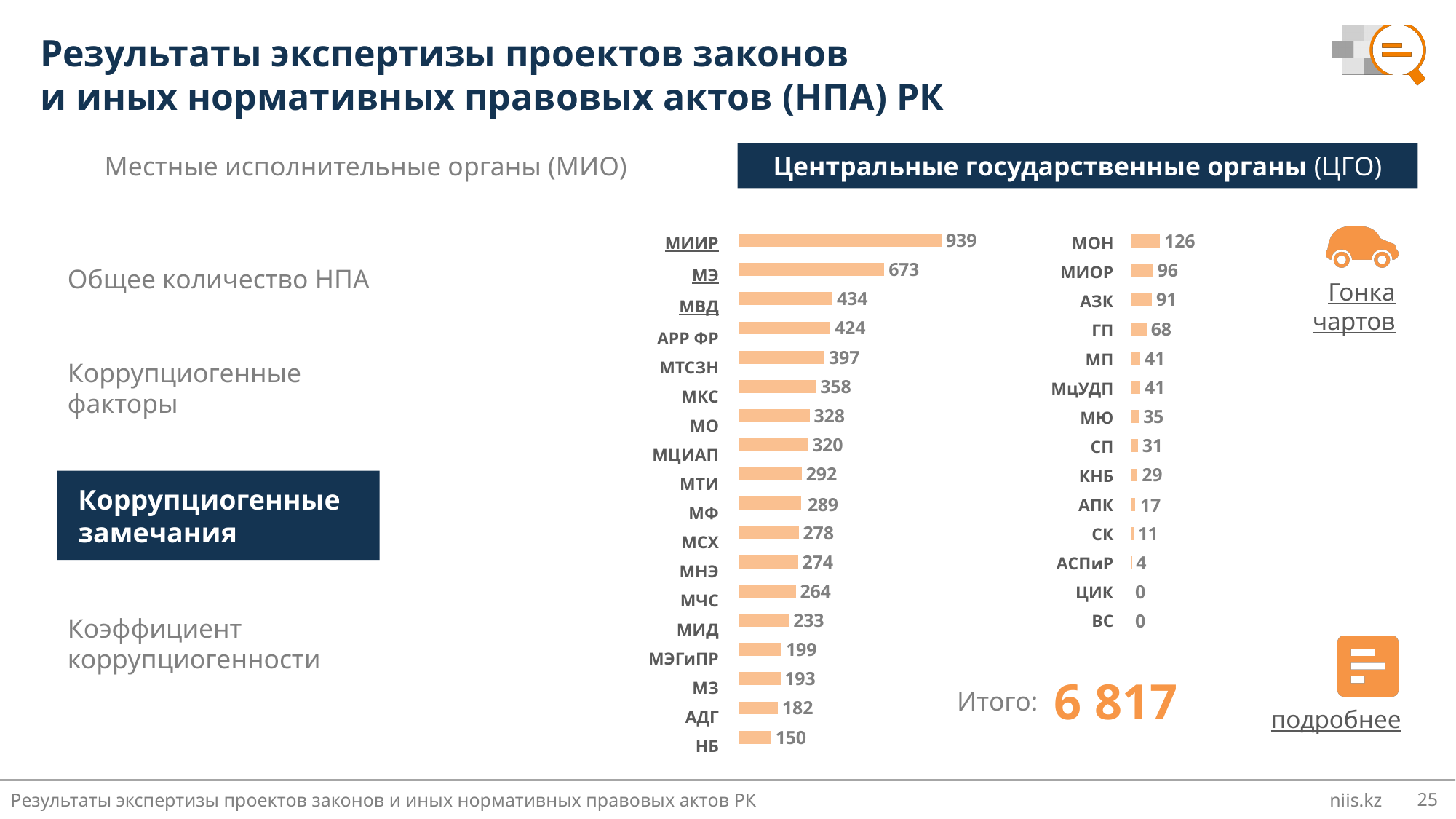
What is the difference between the values for МИИР and МЭ? 266 What is the value for НБ? 150 What total (Итого) is shown for the chart? 6 817 What kind of chart is shown? Bar chart What is the value for МОН? 126 Which categories have the lowest value? ЦИК and ВС Which is larger, the value for МКС or the value for МО? МКС What is the value for АСПиР? 4 What is the value for МИИР? 939 Which category has the highest value? МИИР How many categories are shown in the chart? 32 What is the difference between the values for МВД and АРР ФР? 10